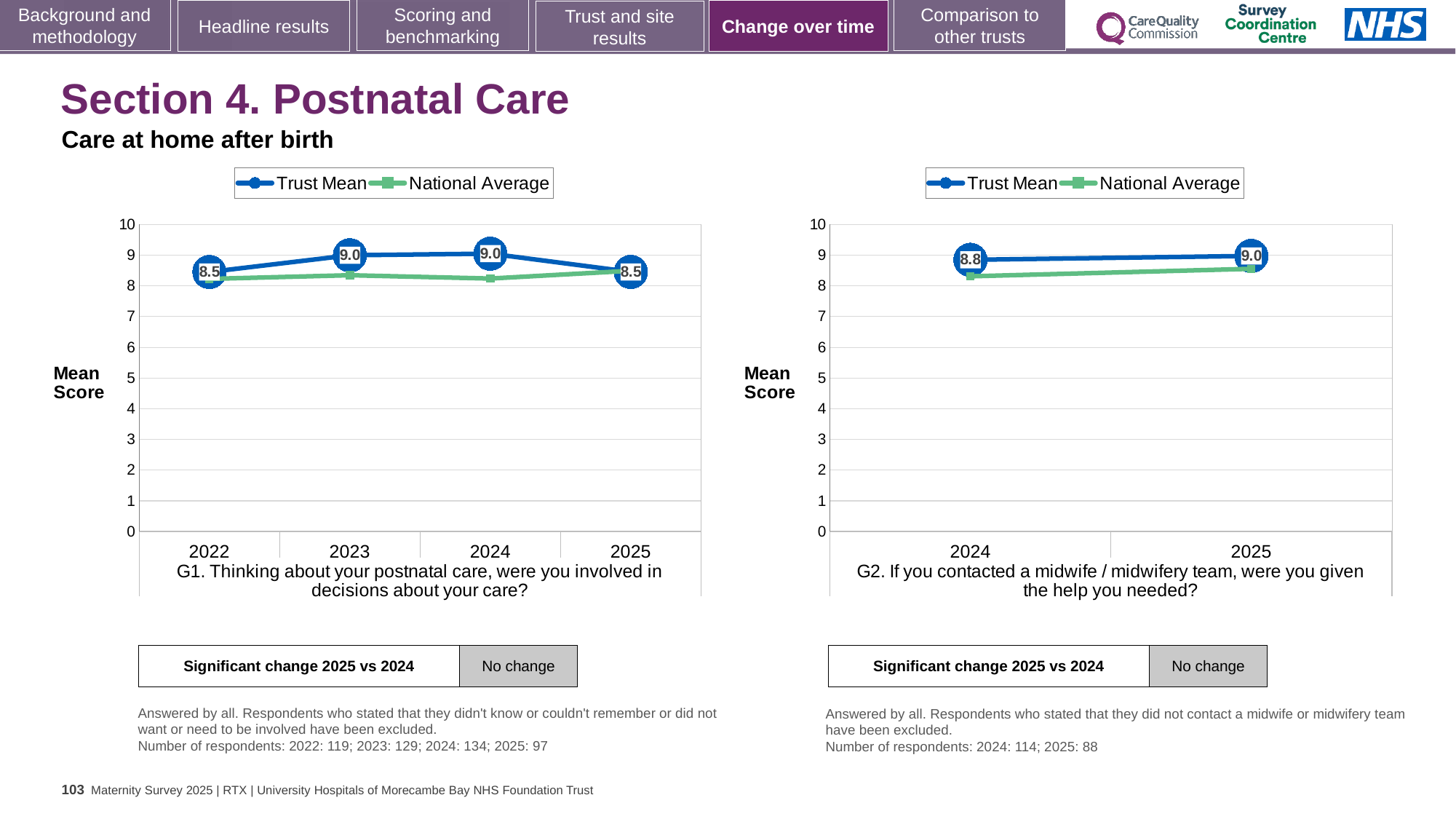
In the G2 chart on the right, how many years are plotted on the x axis? 2 How many series does the legend of the G1 chart on the left list? 2 In the G2 chart on the right, what is the Trust Mean for 2025? 9.0 In the G1 chart on the left, what is the Trust Mean for 2025? 8.5 What kind of chart is the G2 chart on the right? Line chart In the G2 chart on the right, does the Trust Mean rise or fall from 2024 to 2025? Rise In the G1 chart on the left, what is the difference between the Trust Mean in 2023 and in 2022? 0.5 In the G1 chart on the left, what is the Trust Mean for 2023? 9.0 In the G2 chart on the right, which year has the higher Trust Mean, 2024 or 2025? 2025 In the G2 chart on the right, what is the Trust Mean for 2024? 8.8 In the G1 chart on the left, how many years are plotted on the x axis? 4 In the G1 chart on the left, is the National Average for 2022 greater or less than 9? less